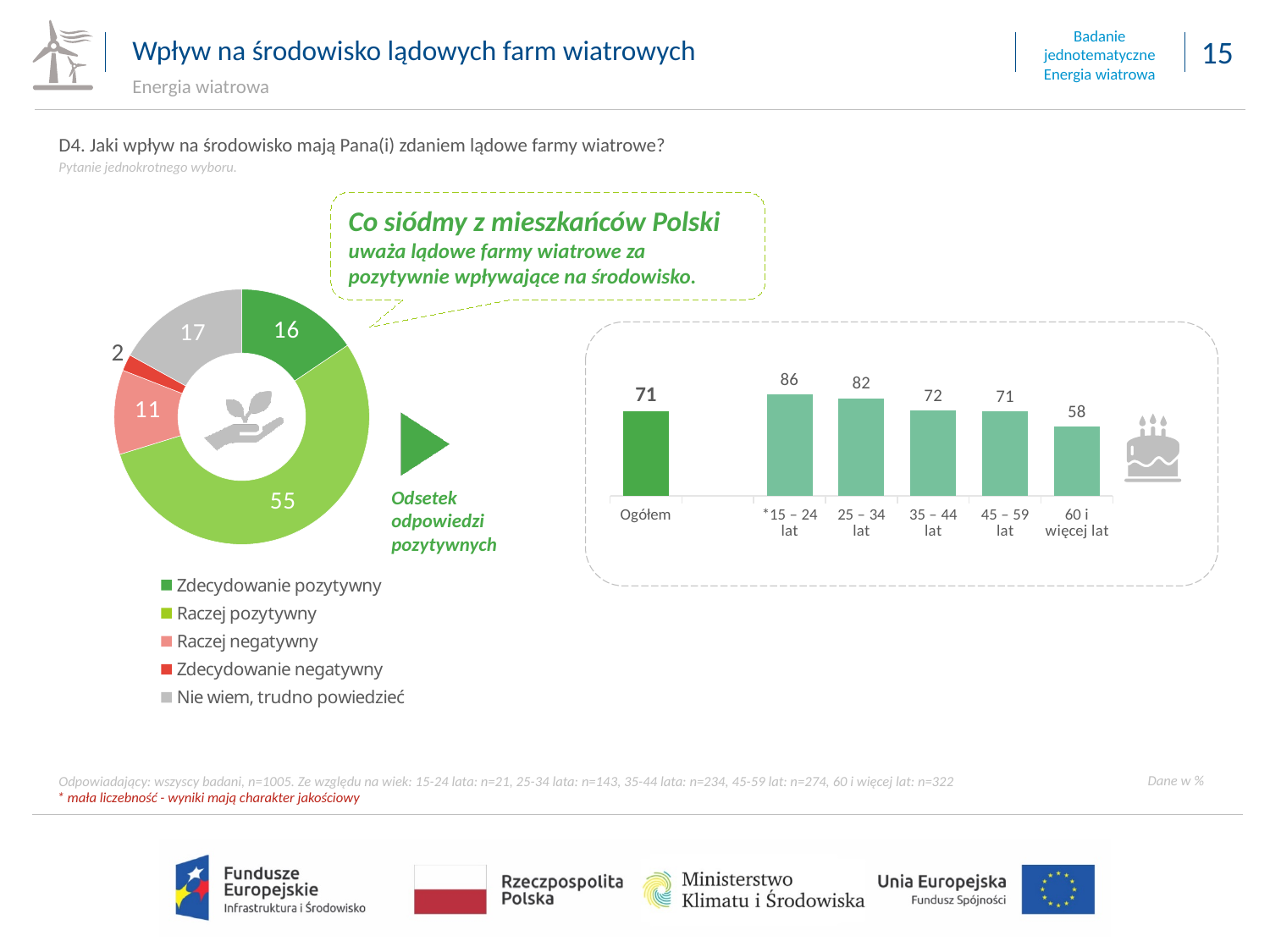
In the donut chart on the left, what is the difference between 'Zdecydowanie pozytywny' and 'Raczej negatywny'? 5 In the donut chart on the left, what is the value for 'Raczej pozytywny'? 55 In the bar chart on the right, what is the value for '25 – 34 lat'? 82 In the donut chart on the left, which category has the smallest value? Zdecydowanie negatywny In the bar chart on the right, which age group has the lowest value? 60 i więcej lat In the donut chart on the left, what is the value for 'Nie wiem, trudno powiedzieć'? 17 In the bar chart on the right, which age group has the highest value? *15 – 24 lat In the donut chart on the left, how many categories does the legend list? 5 In the bar chart on the right, what is the value for 'Ogółem'? 71 In the bar chart on the right, what is the difference between '*15 – 24 lat' and '60 i więcej lat'? 28 In the donut chart on the left, which category has the largest value? Raczej pozytywny In the bar chart on the right, do the values rise or fall across the age groups from '*15 – 24 lat' to '60 i więcej lat'? fall